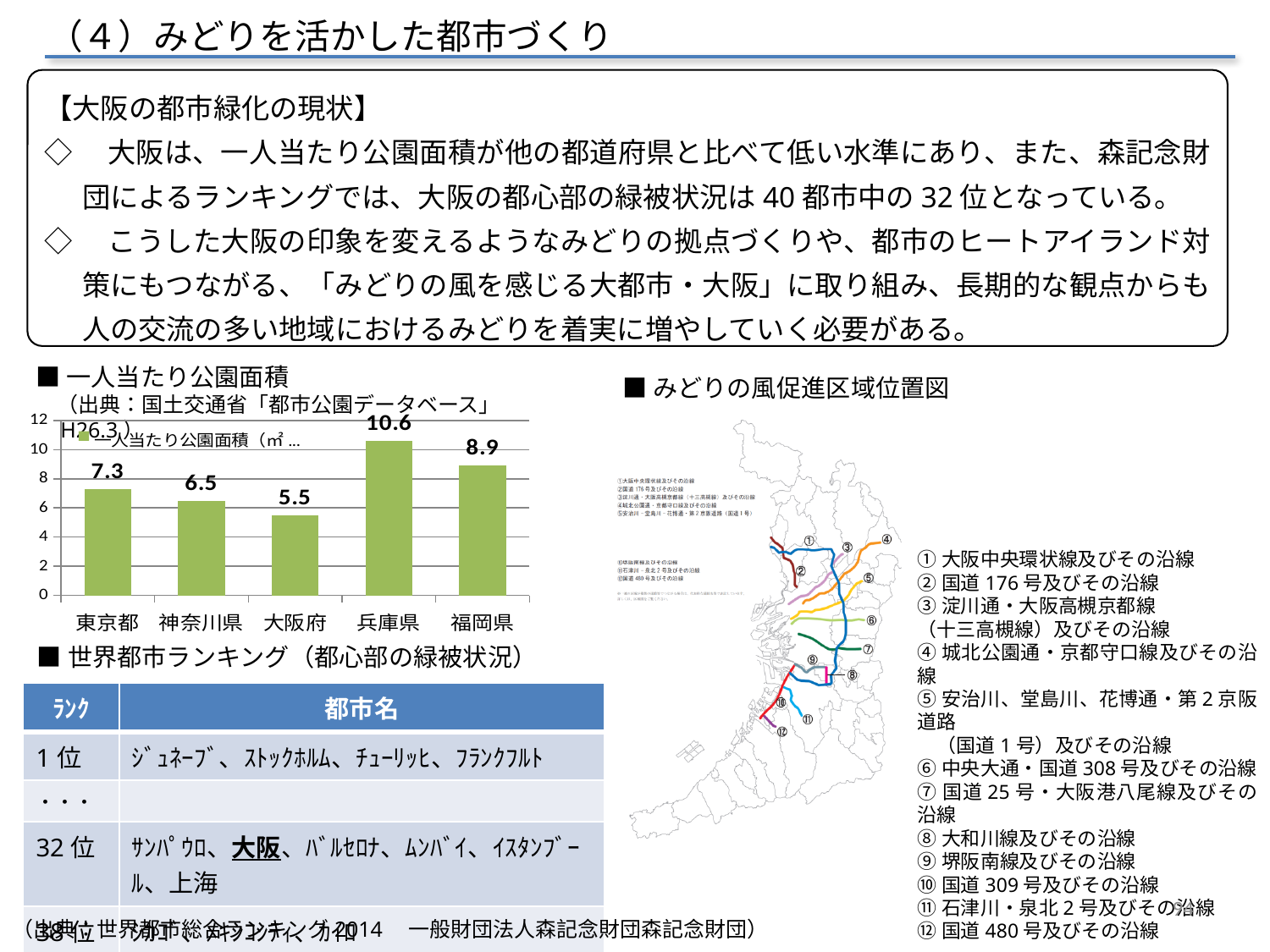
「一人当たり公園面積」のグラフで、兵庫県と大阪府の値の差はいくつですか？ 5.1 「一人当たり公園面積」のグラフで、福岡県と神奈川県の値の差はいくつですか？ 2.4 「一人当たり公園面積」のグラフには、いくつの都道府県が示されていますか？ 5 「一人当たり公園面積」のグラフはどの種類のグラフですか？ 棒グラフ 「一人当たり公園面積」のグラフで、最も値が高いのはどの都道府県ですか？ 兵庫県 「一人当たり公園面積」のグラフで、福岡県の値は8より大きいですか、小さいですか？ 大きい 「一人当たり公園面積」のグラフで、東京都と神奈川県ではどちらの値が大きいですか？ 東京都 「一人当たり公園面積」のグラフで、大阪府の値はいくつですか？ 5.5 「一人当たり公園面積」のグラフで、最も値が低いのはどの都道府県ですか？ 大阪府 「一人当たり公園面積」のグラフで、兵庫県の値はいくつですか？ 10.6 「一人当たり公園面積」のグラフの出典はどこですか？ 国土交通省「都市公園データベース」 「一人当たり公園面積」のグラフで、東京都の値はいくつですか？ 7.3